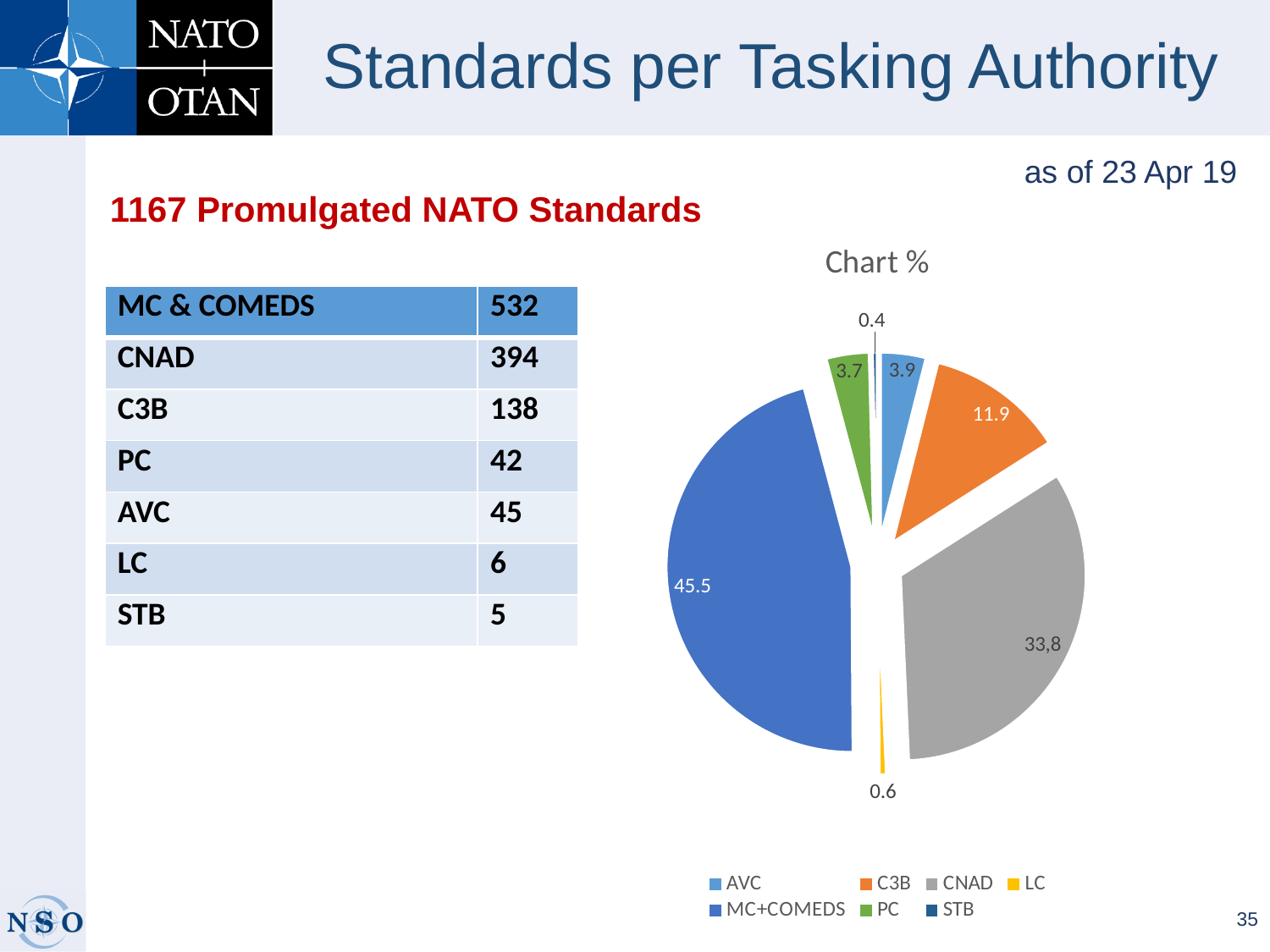
Which category has the smallest slice in the pie chart? STB What value is shown for the C3B slice of the pie chart? 11.9 What is the title of the chart? Chart % What type of chart is shown on the slide? pie chart Which category has the largest slice in the pie chart? MC+COMEDS What value is shown for the LC slice of the pie chart? 0.6 Which slice is larger in the pie chart, CNAD or C3B? CNAD What value is shown for the CNAD slice of the pie chart? 33,8 How many categories does the legend of the pie chart list? 7 What value is shown for the AVC slice of the pie chart? 3.9 What value is shown for the MC+COMEDS slice of the pie chart? 45.5 What is the difference between the MC+COMEDS value and the C3B value in the pie chart? 33.6